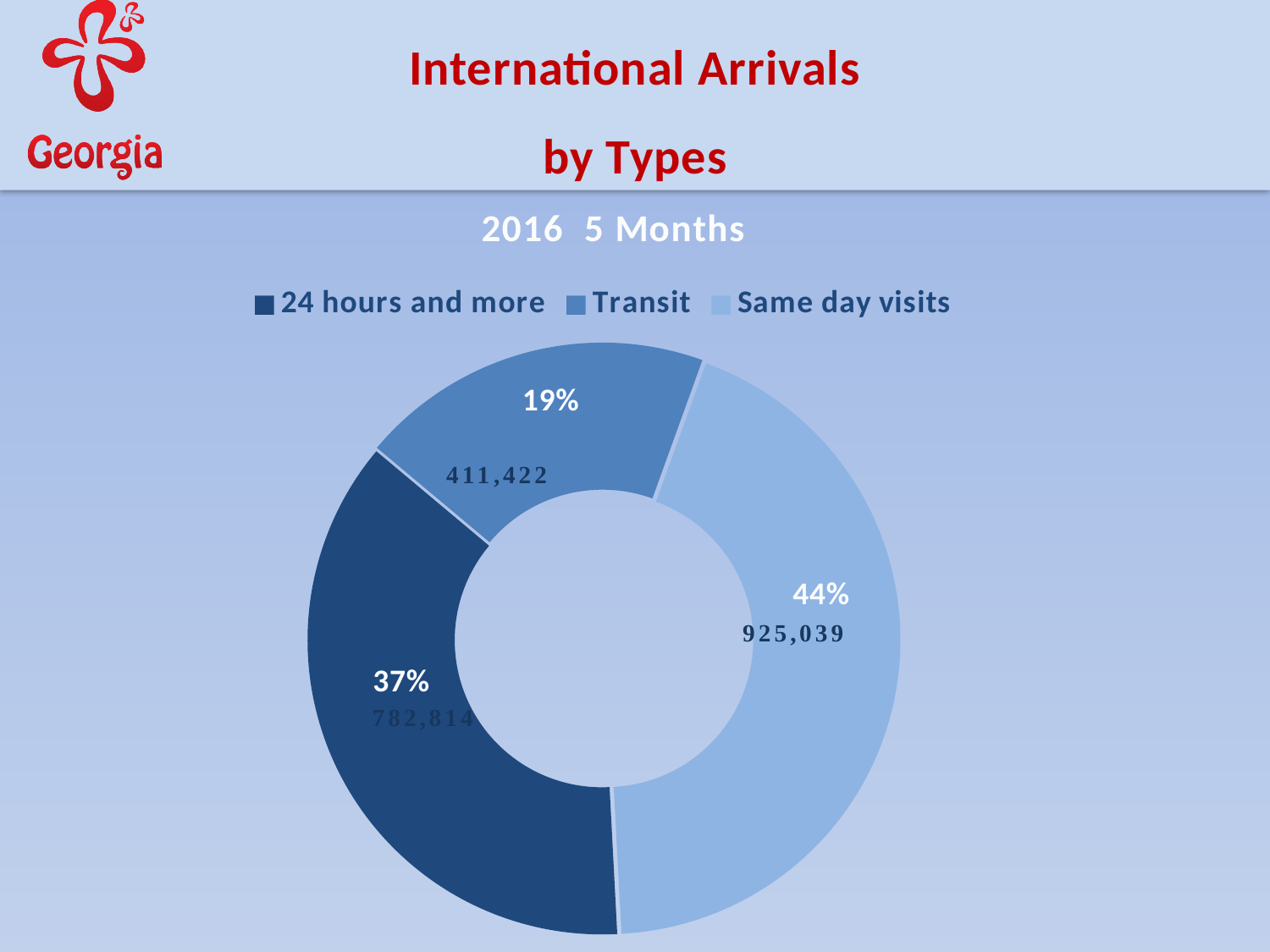
What is the number of arrivals for Transit? 411,422 What is the number of arrivals for 24 hours and more? 782,814 How many categories does the chart show? 3 Which category has the smallest share of arrivals? Transit What share of the chart does 24 hours and more represent? 37% What share of the chart does Transit represent? 19% Which category has the largest share of arrivals? Same day visits What period does the chart cover, according to its title? 2016 5 Months What is the number of arrivals for Same day visits? 925,039 What is the difference in arrivals between Same day visits and 24 hours and more? 142,225 What share of the chart does Same day visits represent? 44% What kind of chart is shown on the slide? Doughnut (pie) chart